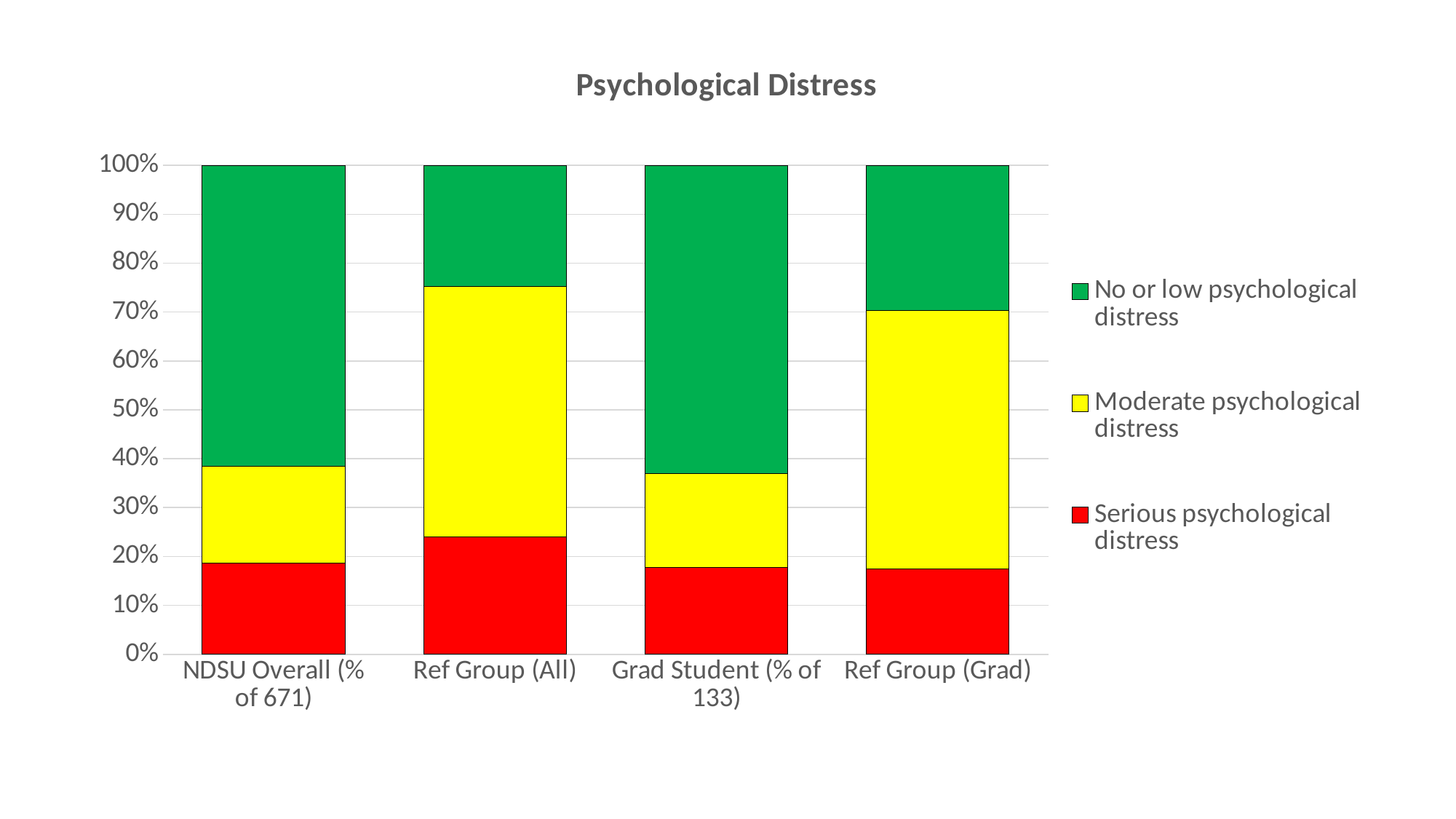
Which has a larger share of No or low psychological distress: Grad Student (% of 133) or Ref Group (Grad)? Grad Student (% of 133) Which colour represents Serious psychological distress in the legend? Red Which has a larger share of Moderate psychological distress: NDSU Overall (% of 671) or Ref Group (All)? Ref Group (All) Is the Serious psychological distress value for Ref Group (All) greater or less than 20%? greater Which category has the highest share of Serious psychological distress? Ref Group (All) Which category has the lowest share of No or low psychological distress? Ref Group (All) What is the total height of the stacked bar for Ref Group (All)? 100% What kind of chart is shown on the slide? Stacked bar chart How many categories are shown along the x axis? 4 How many series does the legend list? 3 Is the Serious psychological distress value for NDSU Overall (% of 671) greater or less than 30%? less What is the title of the chart? Psychological Distress